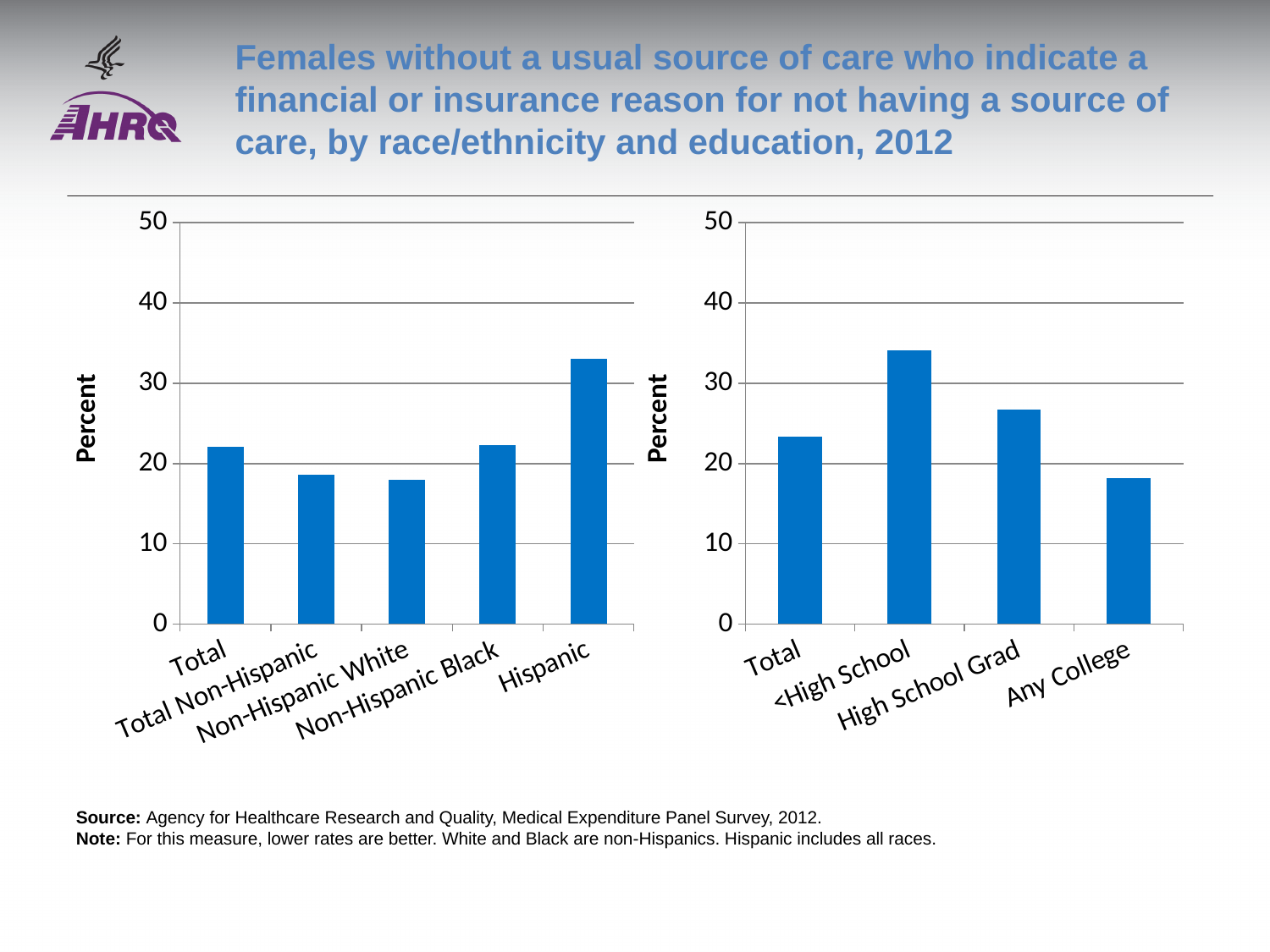
In the left chart (by race/ethnicity), is the value for Non-Hispanic White greater or less than 20? less In the left chart (by race/ethnicity), how many categories are shown on the x axis? 5 In the left chart (by race/ethnicity), which is larger, the value for Hispanic or the value for Total? Hispanic What kind of chart is the left chart on the slide? bar chart In the left chart (by race/ethnicity), is the value for Hispanic greater or less than 30? greater What is the label on the y axis of the charts? Percent In the right chart (by education), is the value for <High School greater or less than 30? greater In the left chart (by race/ethnicity), which category has the highest value? Hispanic In the right chart (by education), which is larger, the value for High School Grad or the value for Any College? High School Grad In the right chart (by education), which category has the lowest value? Any College In the right chart (by education), how many categories are shown on the x axis? 4 In the right chart (by education), which category has the highest value? <High School